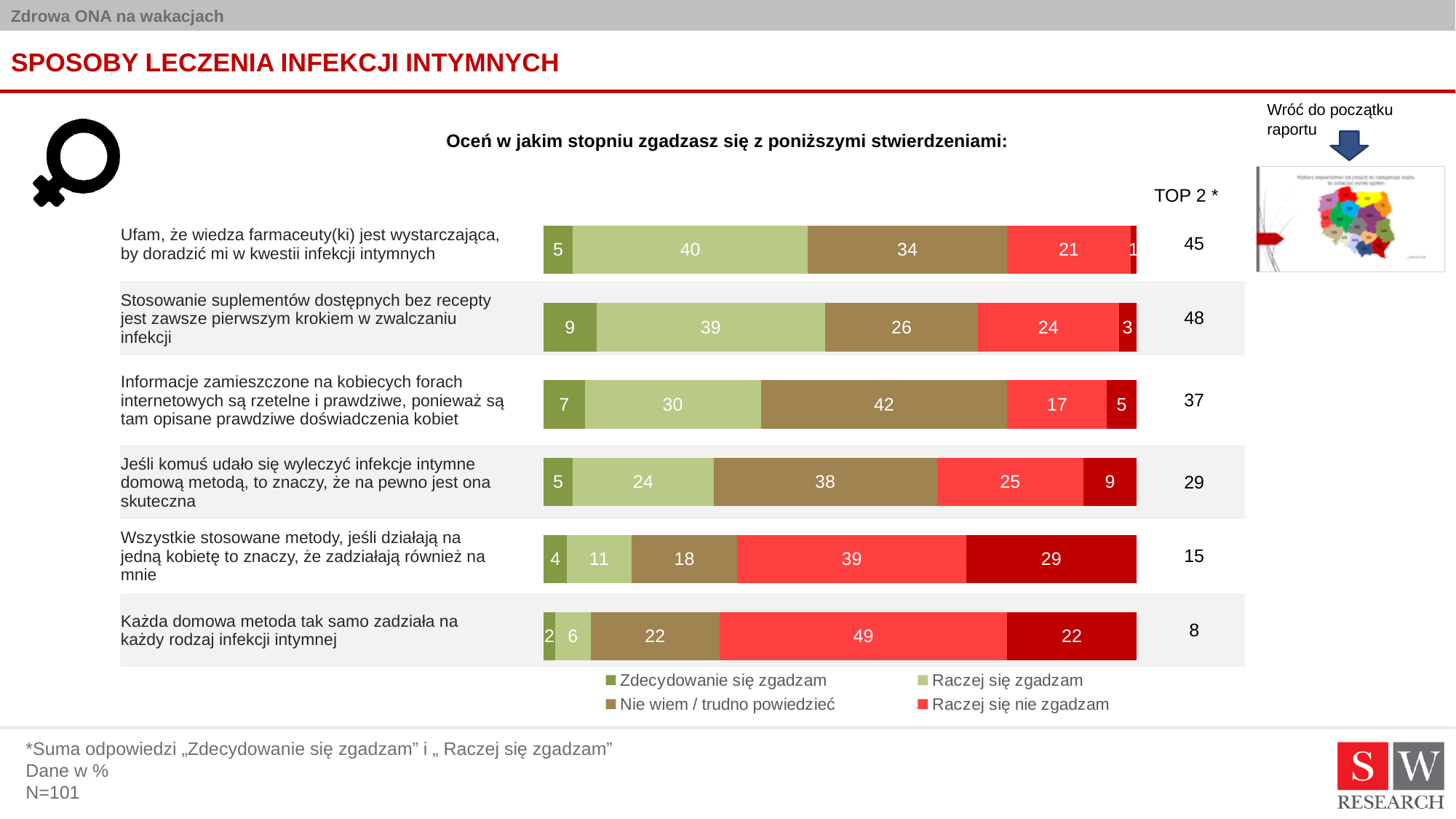
What is the 'Nie wiem / trudno powiedzieć' value for the statement 'Informacje zamieszczone na kobiecych forach internetowych są rzetelne i prawdziwe...'? 42 What is the difference between the TOP 2 values for 'Stosowanie suplementów dostępnych bez recepty...' and 'Wszystkie stosowane metody, jeśli działają na jedną kobietę...'? 33 Which statement has the lowest TOP 2 value? Każda domowa metoda tak samo zadziała na każdy rodzaj infekcji intymnej What is the 'Raczej się nie zgadzam' value for the statement 'Każda domowa metoda tak samo zadziała na każdy rodzaj infekcji intymnej'? 49 Which statement has the highest TOP 2 value? Stosowanie suplementów dostępnych bez recepty jest zawsze pierwszym krokiem w zwalczaniu infekcji What is the TOP 2 value for the statement 'Jeśli komuś udało się wyleczyć infekcje intymne domową metodą, to znaczy, że na pewno jest ona skuteczna'? 29 What kind of chart is shown on the slide? stacked bar chart Which is larger: the 'Zdecydowanie się zgadzam' value for 'Stosowanie suplementów dostępnych bez recepty...' or for 'Jeśli komuś udało się wyleczyć infekcje intymne domową metodą...'? Stosowanie suplementów dostępnych bez recepty... What is the 'Raczej się zgadzam' value for the statement 'Ufam, że wiedza farmaceuty(ki) jest wystarczająca, by doradzić mi w kwestii infekcji intymnych'? 40 How many series does the chart's legend list? 4 How many statements (categories) are plotted in the chart? 6 What is the sample size (N) stated on the slide? N=101